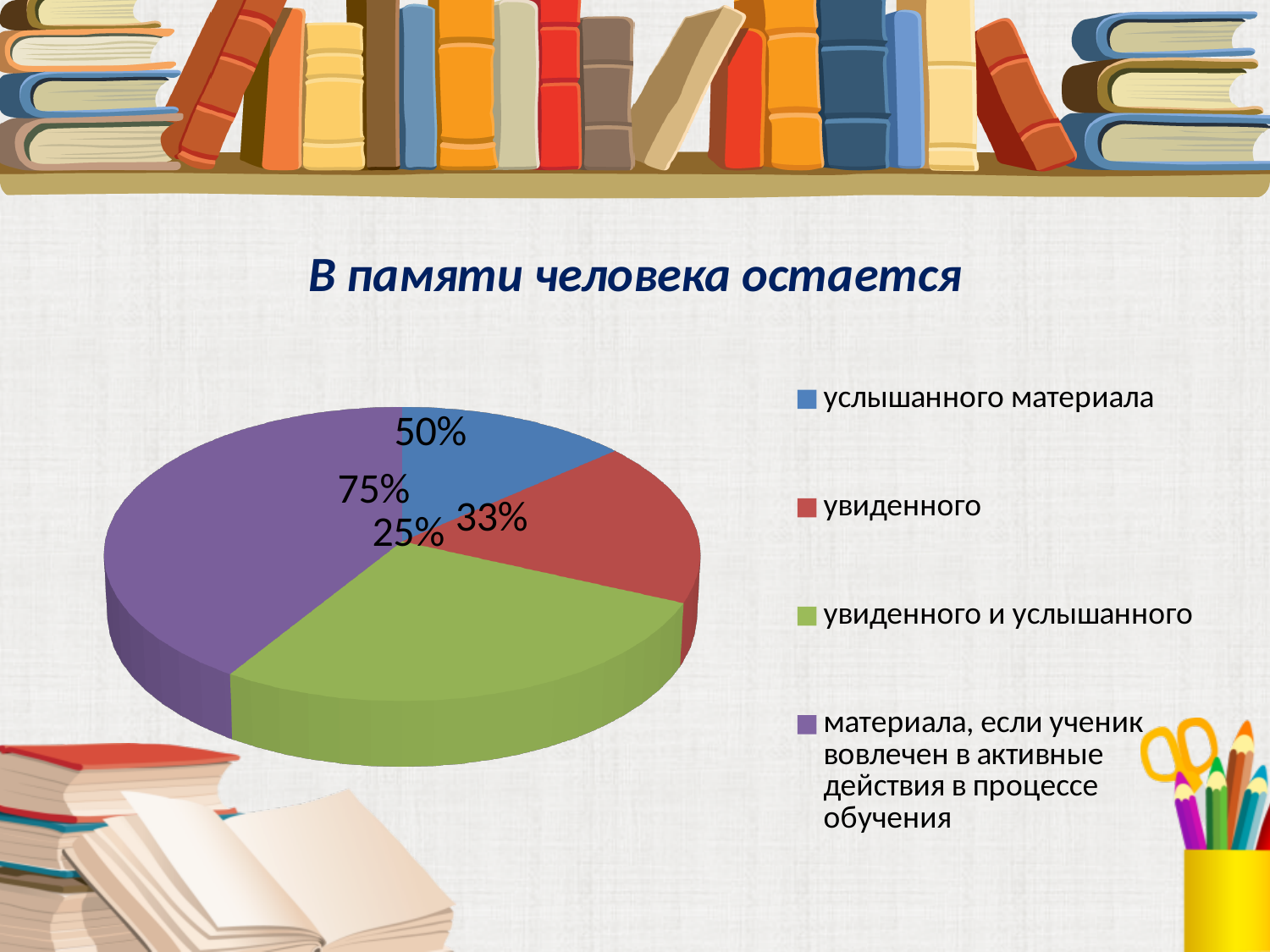
Which category has the smallest slice of the pie? услышанного материала What colour is the slice for 'увиденного и услышанного'? green What kind of chart is shown on the slide? pie chart Which slice is larger: 'увиденного и услышанного' or 'увиденного'? увиденного и услышанного How many entries does the legend list? 4 What is the title of the chart? В памяти человека остается Which slice is larger: 'увиденного и услышанного' or 'услышанного материала'? увиденного и услышанного Which category has the largest slice of the pie? материала, если ученик вовлечен в активные действия в процессе обучения Which slice is larger: 'услышанного материала' or 'увиденного'? увиденного How many slices does the pie chart have? 4